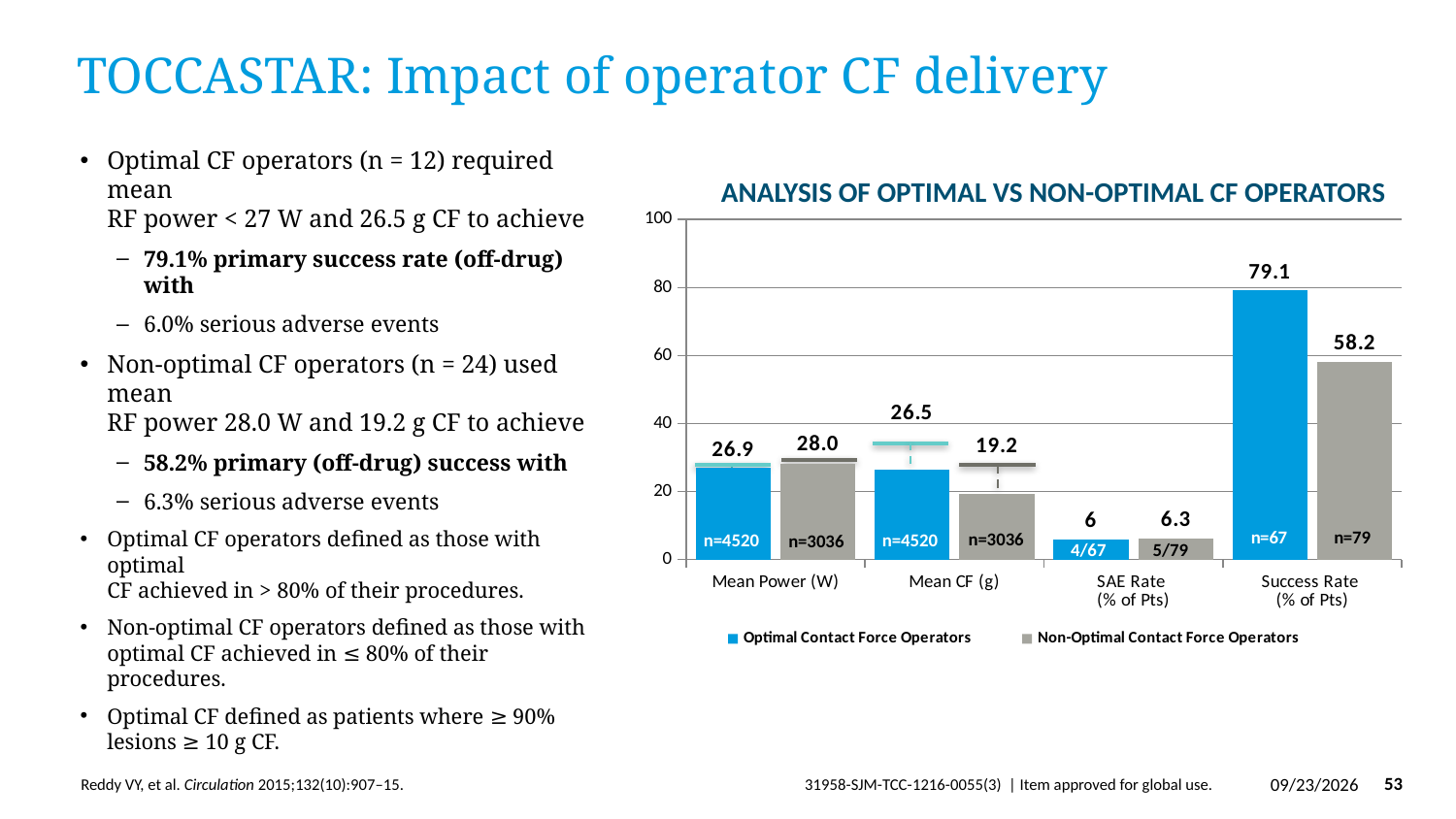
What is the Success Rate (% of Pts) for Optimal Contact Force Operators? 79.1 For Mean CF (g), which series has the larger value, Optimal or Non-Optimal Contact Force Operators? Optimal Contact Force Operators Which category has the highest value for Optimal Contact Force Operators? Success Rate (% of Pts) What kind of chart is shown on the slide? bar chart What is the difference in Success Rate (% of Pts) between Optimal and Non-Optimal Contact Force Operators? 20.9 What is the SAE Rate (% of Pts) for Non-Optimal Contact Force Operators? 6.3 What is the title of the chart? ANALYSIS OF OPTIMAL VS NON-OPTIMAL CF OPERATORS What is the Mean Power (W) for Optimal Contact Force Operators? 26.9 How many series does the chart legend list? 2 What is the Mean CF (g) for Non-Optimal Contact Force Operators? 19.2 How many categories are shown on the x axis of the chart? 4 Which category has the lowest value for Non-Optimal Contact Force Operators? SAE Rate (% of Pts)